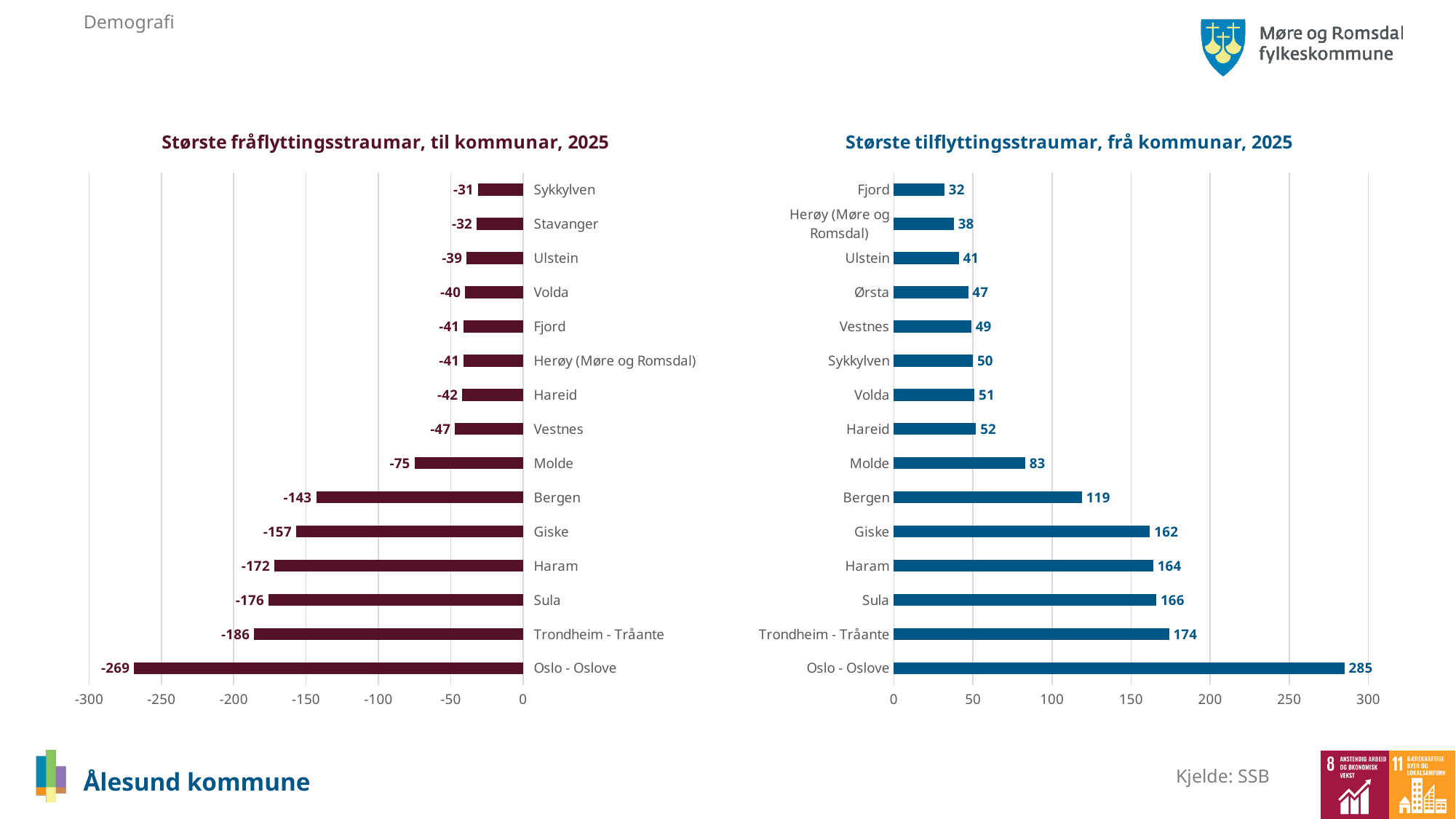
In the chart 'Største fråflyttingsstraumar, til kommunar, 2025', which municipality has the smallest magnitude of outflow (value closest to zero)? Sykkylven In the chart 'Største fråflyttingsstraumar, til kommunar, 2025', what is the value for Trondheim - Tråante? -186 In the chart 'Største tilflyttingsstraumar, frå kommunar, 2025', which is larger, the value for Giske or the value for Bergen? Giske What type of chart is 'Største tilflyttingsstraumar, frå kommunar, 2025'? Bar chart In the chart 'Største tilflyttingsstraumar, frå kommunar, 2025', what is the difference between the values for Oslo - Oslove and Trondheim - Tråante? 111 How many municipalities are shown in the chart 'Største fråflyttingsstraumar, til kommunar, 2025'? 15 In the chart 'Største tilflyttingsstraumar, frå kommunar, 2025', what is the value for Oslo - Oslove? 285 In the chart 'Største fråflyttingsstraumar, til kommunar, 2025', what is the difference between the values for Sula and Haram? 4 In the chart 'Største tilflyttingsstraumar, frå kommunar, 2025', which municipality has the lowest value? Fjord In the chart 'Største tilflyttingsstraumar, frå kommunar, 2025', what is the value for Molde? 83 In the chart 'Største fråflyttingsstraumar, til kommunar, 2025', what is the value for Bergen? -143 In the chart 'Største tilflyttingsstraumar, frå kommunar, 2025', which municipality has the highest value? Oslo - Oslove